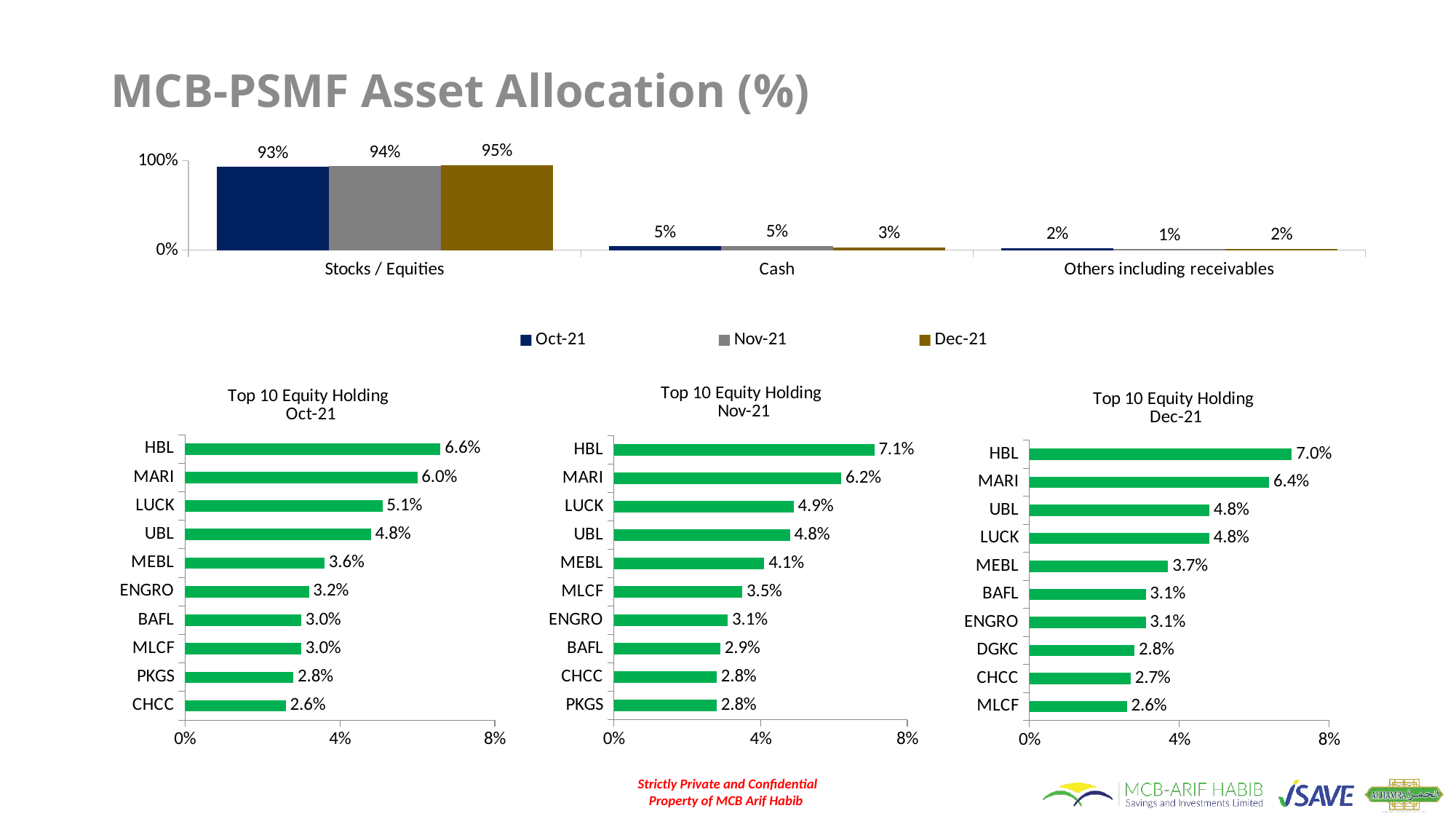
In the MCB-PSMF Asset Allocation chart, how many series does the legend list? 3 In the MCB-PSMF Asset Allocation chart, what is the value for Stocks / Equities in Dec-21? 95% In the Top 10 Equity Holding Dec-21 chart, what is the difference between the values for HBL and MLCF? 4.4% In the Top 10 Equity Holding Oct-21 chart, what is the value for LUCK? 5.1% In the MCB-PSMF Asset Allocation chart, what is the difference between the Stocks / Equities values for Dec-21 and Oct-21? 2% In the Top 10 Equity Holding Nov-21 chart, which holding has the highest value? HBL In the MCB-PSMF Asset Allocation chart, what is the value for Cash in Nov-21? 5% In the Top 10 Equity Holding Dec-21 chart, what is the value for DGKC? 2.8% What kind of chart is the Top 10 Equity Holding Oct-21 chart? Bar chart In the Top 10 Equity Holding Nov-21 chart, what is the value for MEBL? 4.1% In the Top 10 Equity Holding Dec-21 chart, which is larger, the value for MARI or the value for UBL? MARI In the Top 10 Equity Holding Oct-21 chart, which holding has the lowest value? CHCC